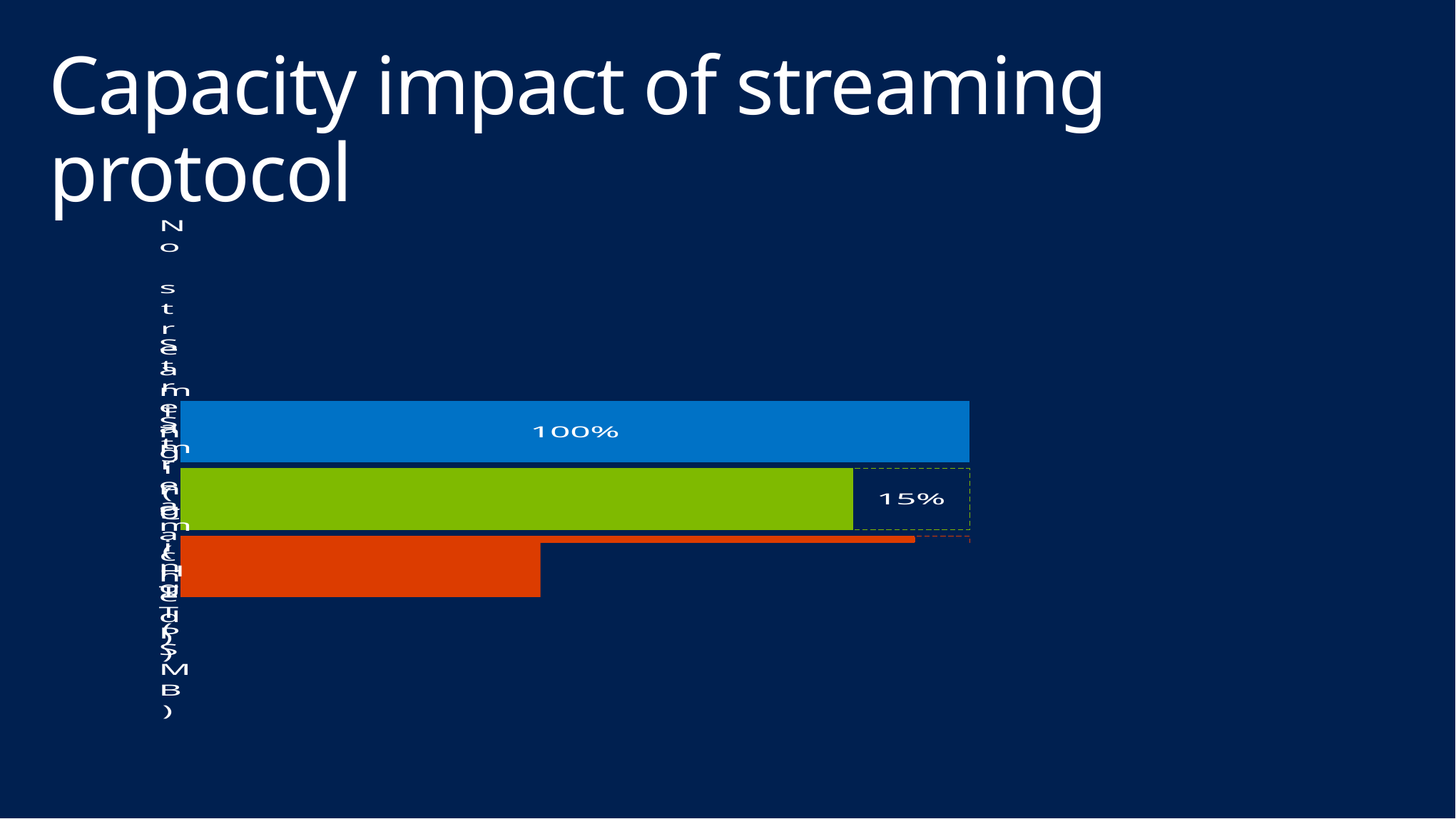
What value is labelled on the blue (top) bar? 100% What percentage label appears in the dashed box to the right of the green (middle) bar? 15% What colour is the top bar in the chart? blue Which bar is the longest in the chart: the blue, green or red one? blue What kind of chart is shown on the slide? bar chart Is the blue (top) bar longer or shorter than the green (middle) bar? longer How many bars are plotted in the chart? 3 What is the title of the slide containing the chart? Capacity impact of streaming protocol